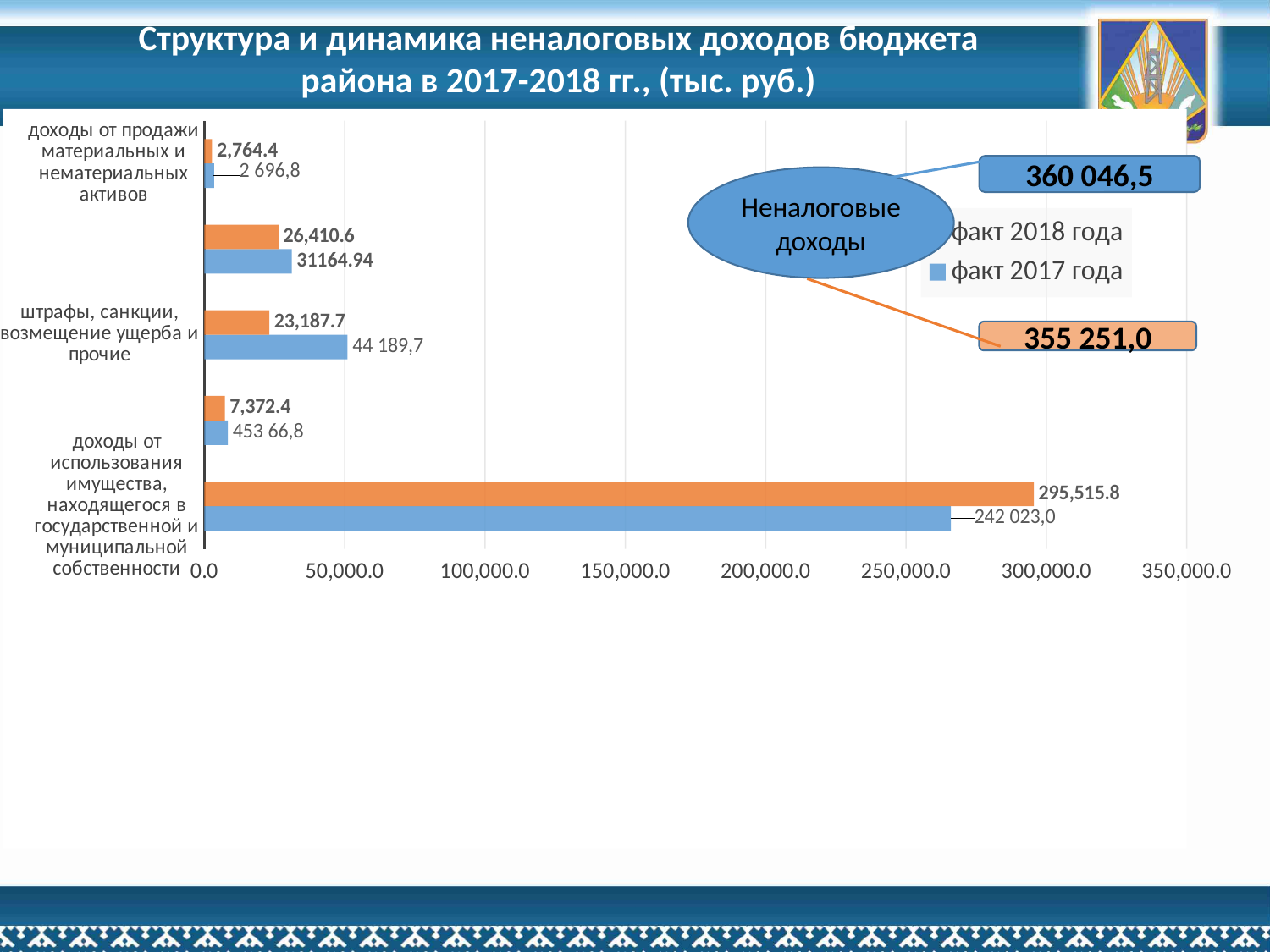
What is the факт 2017 года value for 'доходы от использования имущества, находящегося в государственной и муниципальной собственности'? 242 023,0 Is the факт 2017 года value for 'доходы от использования имущества, находящегося в государственной и муниципальной собственности' greater or less than 200,000.0? greater What value is shown in the blue callout box linked to 'Неналоговые доходы'? 360 046,5 What is the факт 2017 года value for 'штрафы, санкции, возмещение ущерба и прочие'? 44 189,7 What are the two series named in the legend? факт 2018 года and факт 2017 года What is the факт 2018 года value for 'доходы от продажи материальных и нематериальных активов'? 2,764.4 How many series does the chart legend list? 2 For 'штрафы, санкции, возмещение ущерба и прочие', which series has the larger value, факт 2018 года or факт 2017 года? факт 2017 года What is the факт 2018 года value for 'доходы от использования имущества, находящегося в государственной и муниципальной собственности'? 295,515.8 What is the difference between the факт 2018 года and факт 2017 года values for 'доходы от продажи материальных и нематериальных активов'? 67.6 Which category has the highest факт 2018 года value? доходы от использования имущества, находящегося в государственной и муниципальной собственности What type of chart is shown on the slide? bar chart